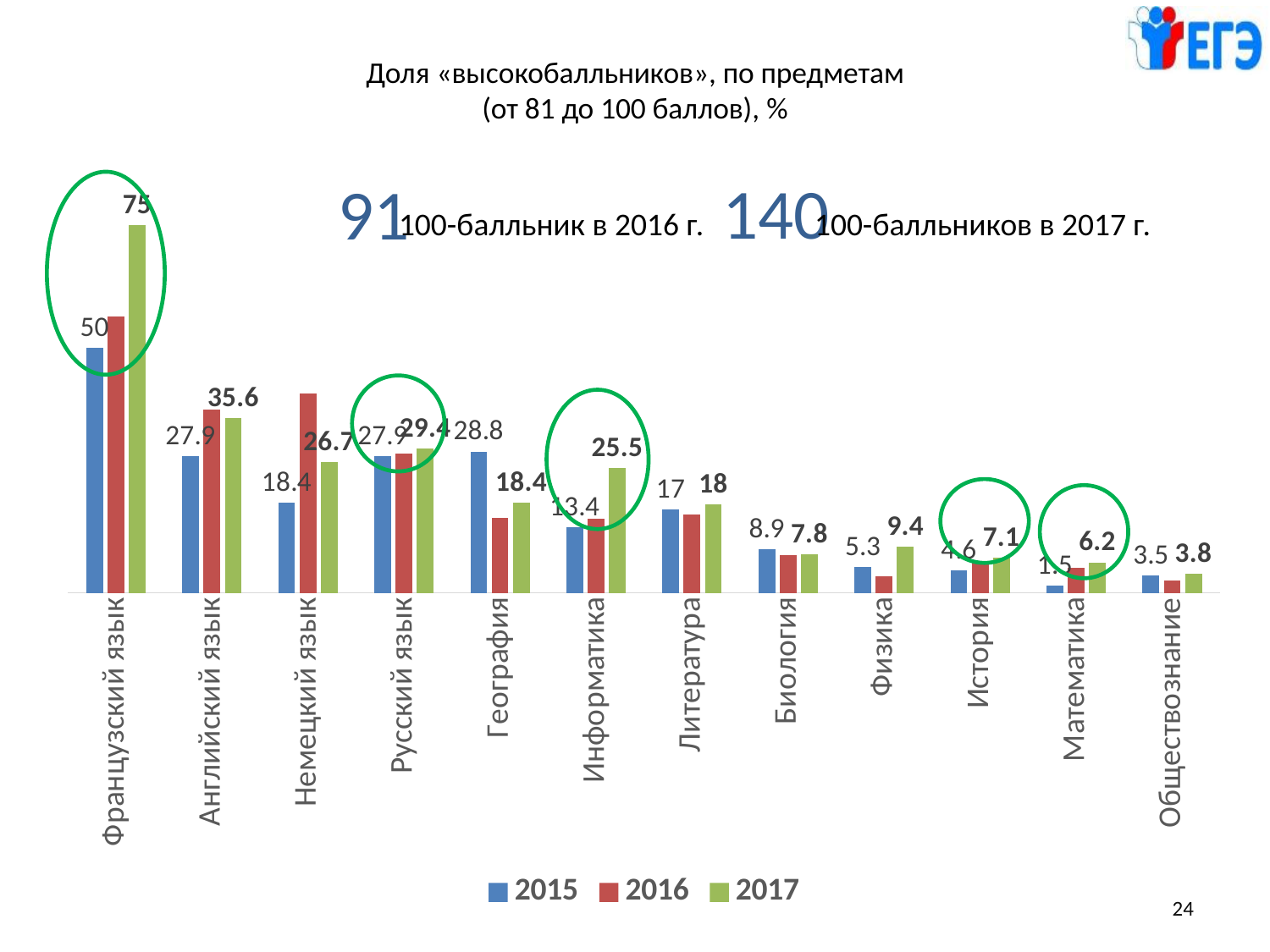
Which subject has the lowest 2015 value? Математика What is the 2015 value for Информатика? 13.4 How many series does the legend list? 3 What is the 2017 value for Французский язык? 75 Which subject has the highest 2017 value? Французский язык How many subject categories are shown on the x axis? 12 Which is larger for География: the 2015 value or the 2017 value? 2015 What is the difference between the 2017 and 2015 values for Информатика? 12.1 Which series is shown in green in the legend? 2017 What is the difference between the 2017 and 2015 values for Английский язык? 7.7 What type of chart is shown on the slide? bar chart What is the 2017 value for Математика? 6.2